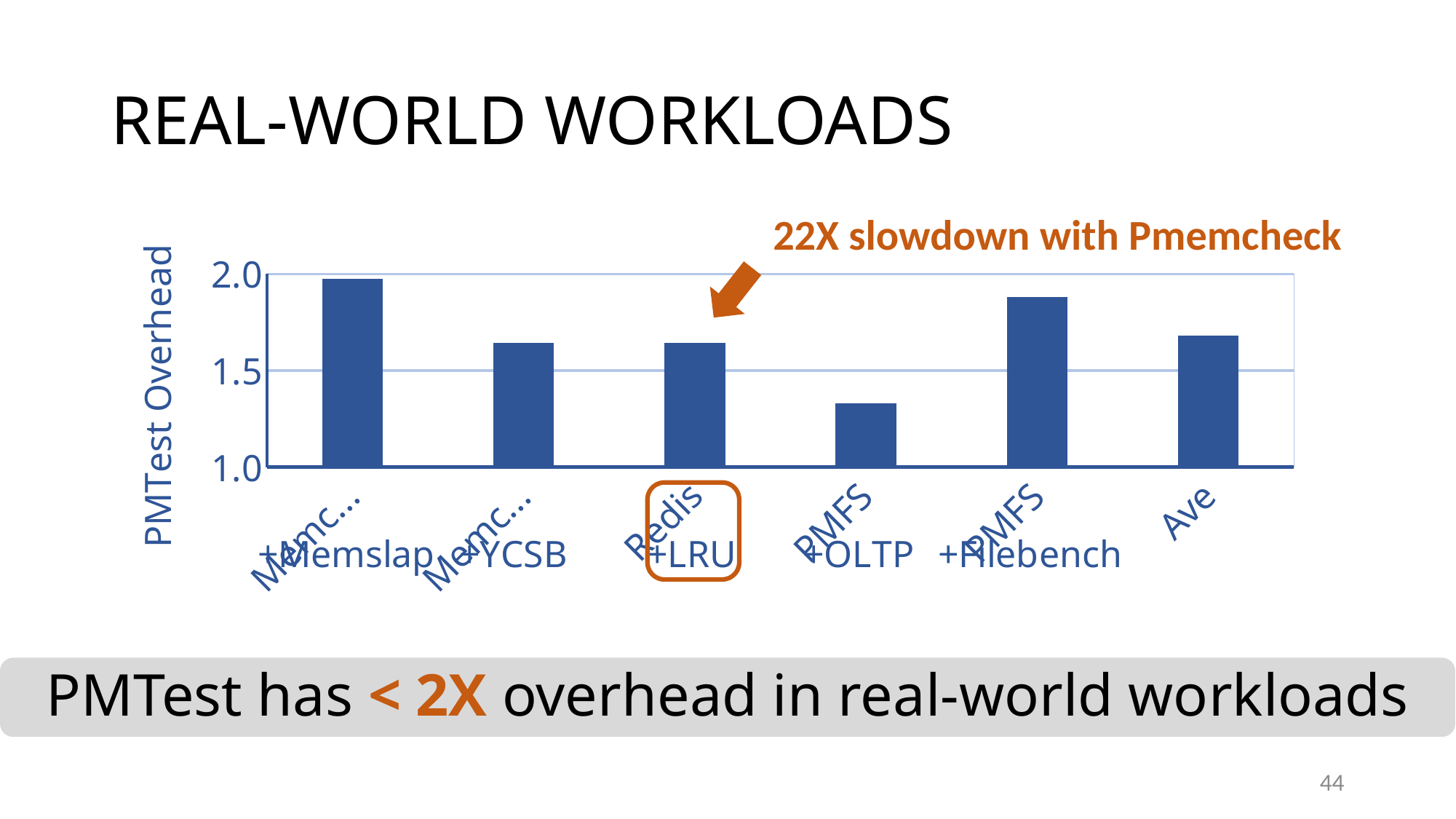
Is the PMTest overhead for PMFS +Filebench greater or less than 2.0? less Which has a higher PMTest overhead, Redis +LRU or PMFS +OLTP? Redis +LRU Which workload has the highest PMTest overhead? Memcached +Memslap Is the PMTest overhead for PMFS +OLTP greater or less than 1.5? less What does the orange annotation above the Redis +LRU bar say? 22X slowdown with Pmemcheck Is the PMTest overhead for Redis +LRU greater or less than 1.5? greater What kind of chart is shown on the slide? bar chart How many bars are plotted in the chart? 6 Which workload has the lowest PMTest overhead? PMFS +OLTP What is the label of the y axis? PMTest Overhead Which has a higher PMTest overhead, Memcached +Memslap or PMFS +Filebench? Memcached +Memslap